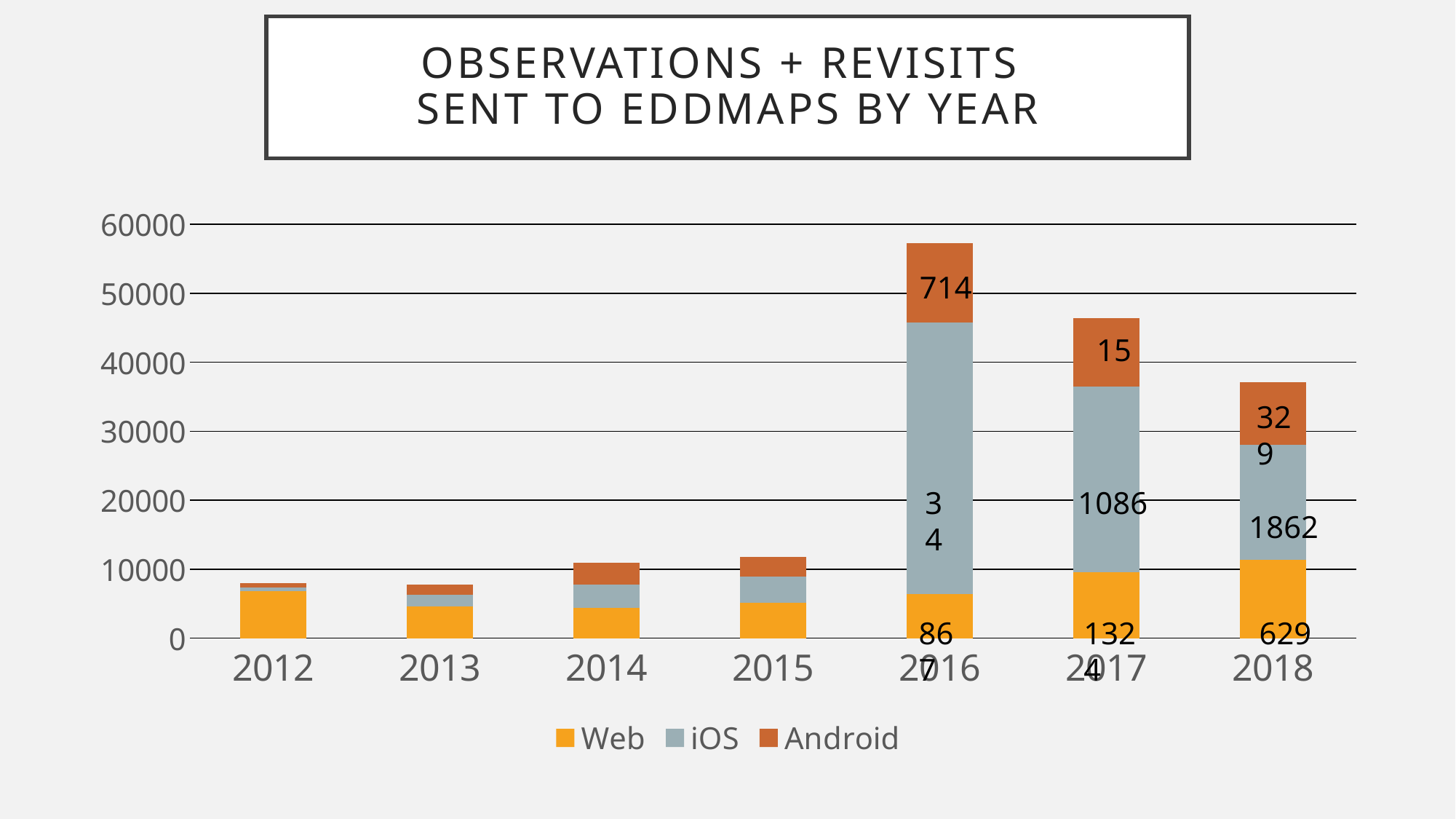
Is the total bar for 2016 greater or less than 50000? greater Which year has the smallest Android segment? 2012 Is the total bar for 2013 greater or less than 10000? less Which year has the tallest total bar? 2016 What kind of chart is shown on the slide? Stacked bar chart Which year has the larger total bar, 2017 or 2018? 2017 How many series does the legend list? 3 Which series makes up the largest part of the 2016 bar? iOS What are the three series named in the legend? Web, iOS, Android How many years are shown on the x axis? 7 Is the total bar for 2018 greater or less than 40000? less From 2016 to 2018, do the total bars rise or fall? fall